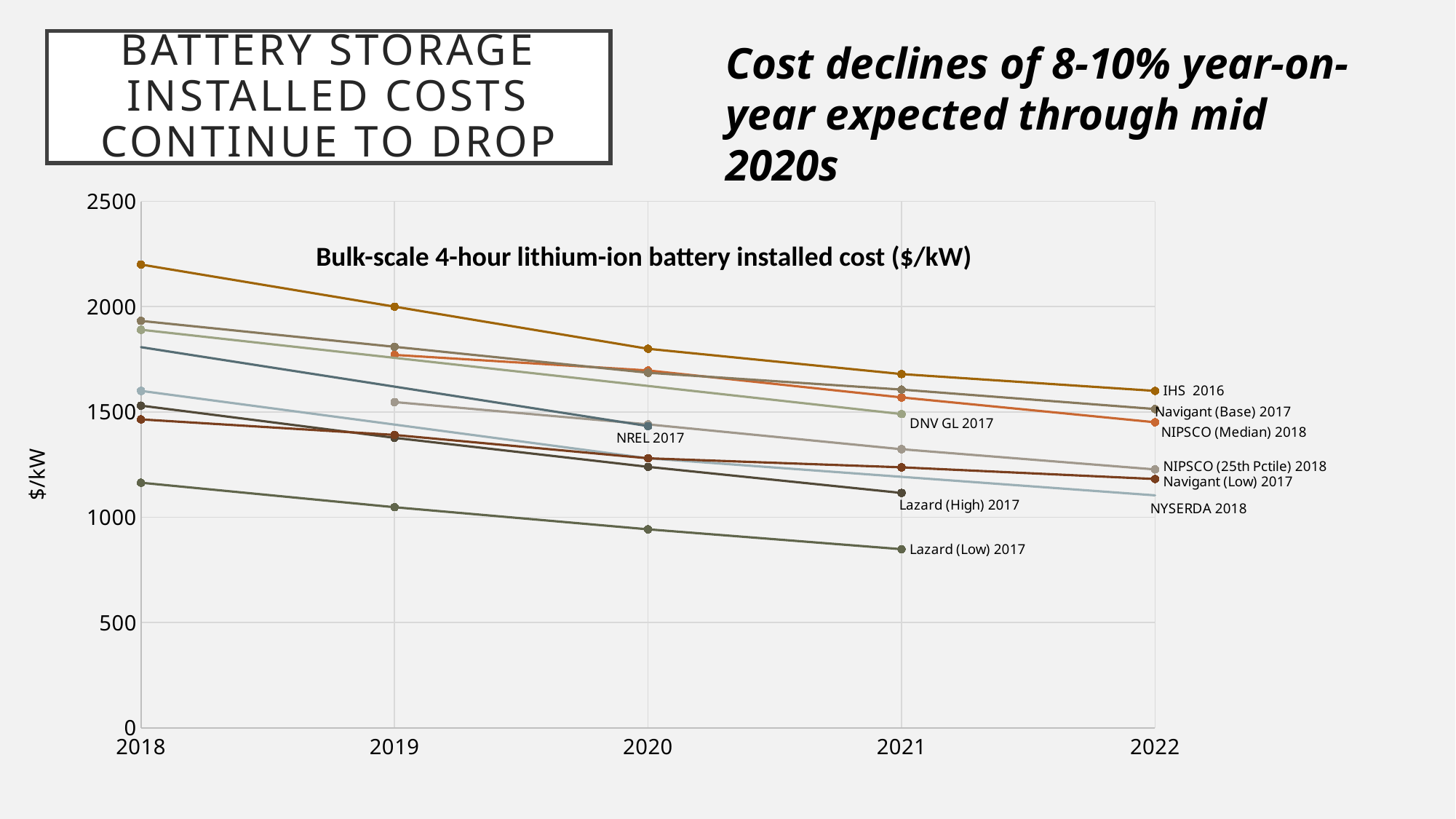
In 2020, which is larger: the value for IHS 2016 or the value for Lazard (Low) 2017? IHS 2016 Is the value for Lazard (Low) 2017 in 2021 greater or less than 1000? less Which series has the lowest installed cost in 2018? Lazard (Low) 2017 How many years are shown along the x axis of the chart? 5 How many labelled series (cost estimates) are plotted on the chart? 10 What kind of chart is shown on the slide? line chart Is the value for IHS 2016 in 2022 greater or less than 1500? greater What is the label on the vertical axis of the chart? $/kW Do the plotted costs rise or fall from 2018 to 2022? fall Which series has the highest installed cost in 2018? IHS 2016 What is the title printed inside the chart area? Bulk-scale 4-hour lithium-ion battery installed cost ($/kW) Is the value for IHS 2016 in 2018 greater or less than 2000? greater